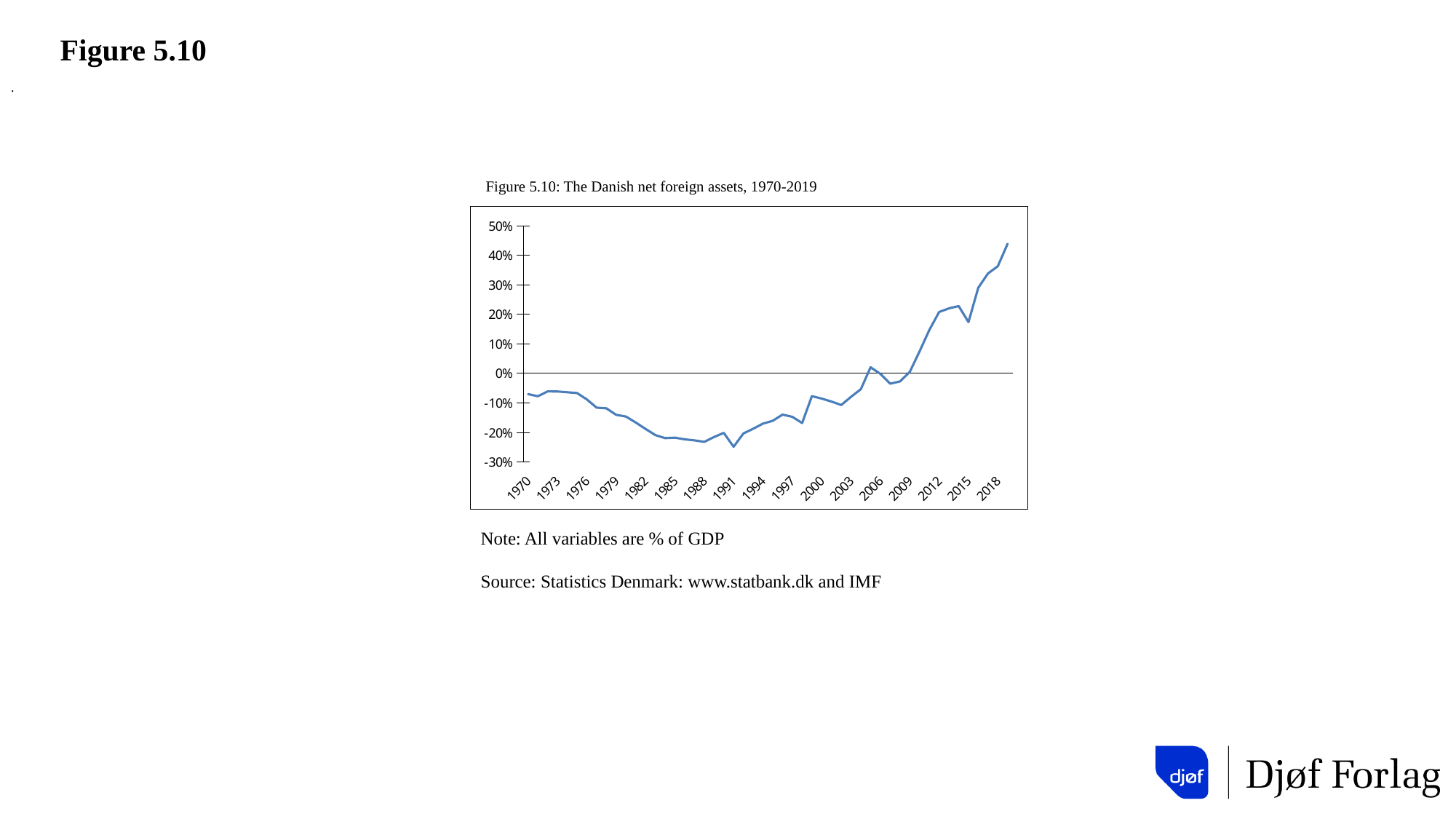
Is the value for 2015 greater or less than 10%? greater Which year has the higher value, 1970 or 1991? 1970 Which year has the higher value, 2000 or 2012? 2012 Does the line rise or fall between 1991 and 2019? rise How many year labels are shown on the x axis? 17 What is the title of the chart? Figure 5.10: The Danish net foreign assets, 1970-2019 In which labelled year does the line reach its lowest value? 1991 Is the value for 1991 greater or less than -20%? less Is the value for 1970 greater or less than 0%? less What kind of chart is shown on the slide? line chart In which year does the line reach its highest value? 2019